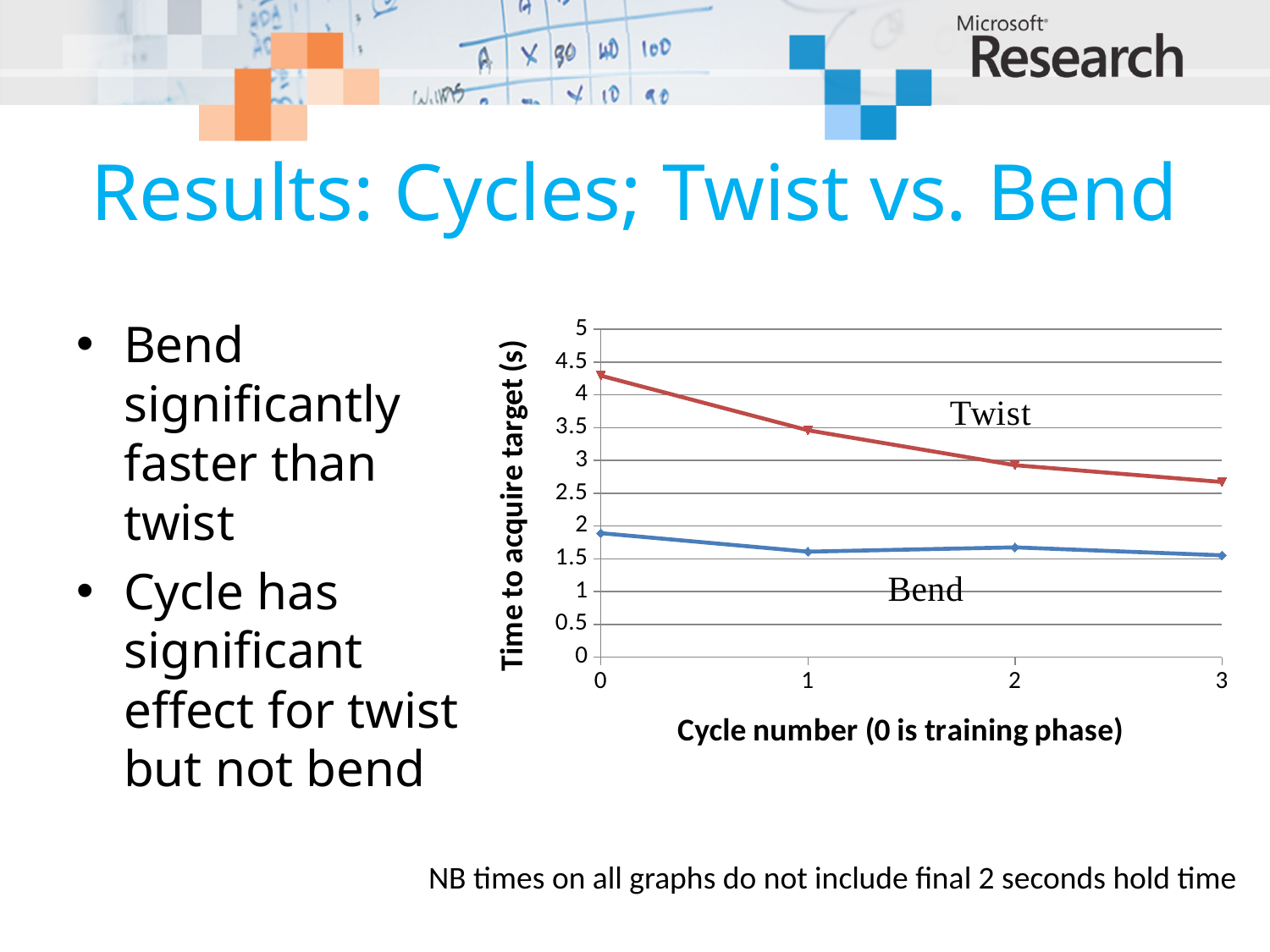
Does the Twist line rise or fall as the cycle number increases from 0 to 3? fall At which cycle number is the Twist time to acquire target lowest? 3 Is the Bend value at cycle 0 greater or less than 2? less At which cycle number is the Twist time to acquire target highest? 0 What colour is the Twist line? red How many lines (series) are plotted on the chart? 2 Is the Twist value at cycle 0 greater or less than 4? greater At cycle 0, which series has the larger time to acquire target, Twist or Bend? Twist Is the Twist value at cycle 3 greater or less than 3? less How many cycle numbers are plotted along the x axis? 4 What is the label of the y axis? Time to acquire target (s) What kind of chart is shown on the slide? line chart